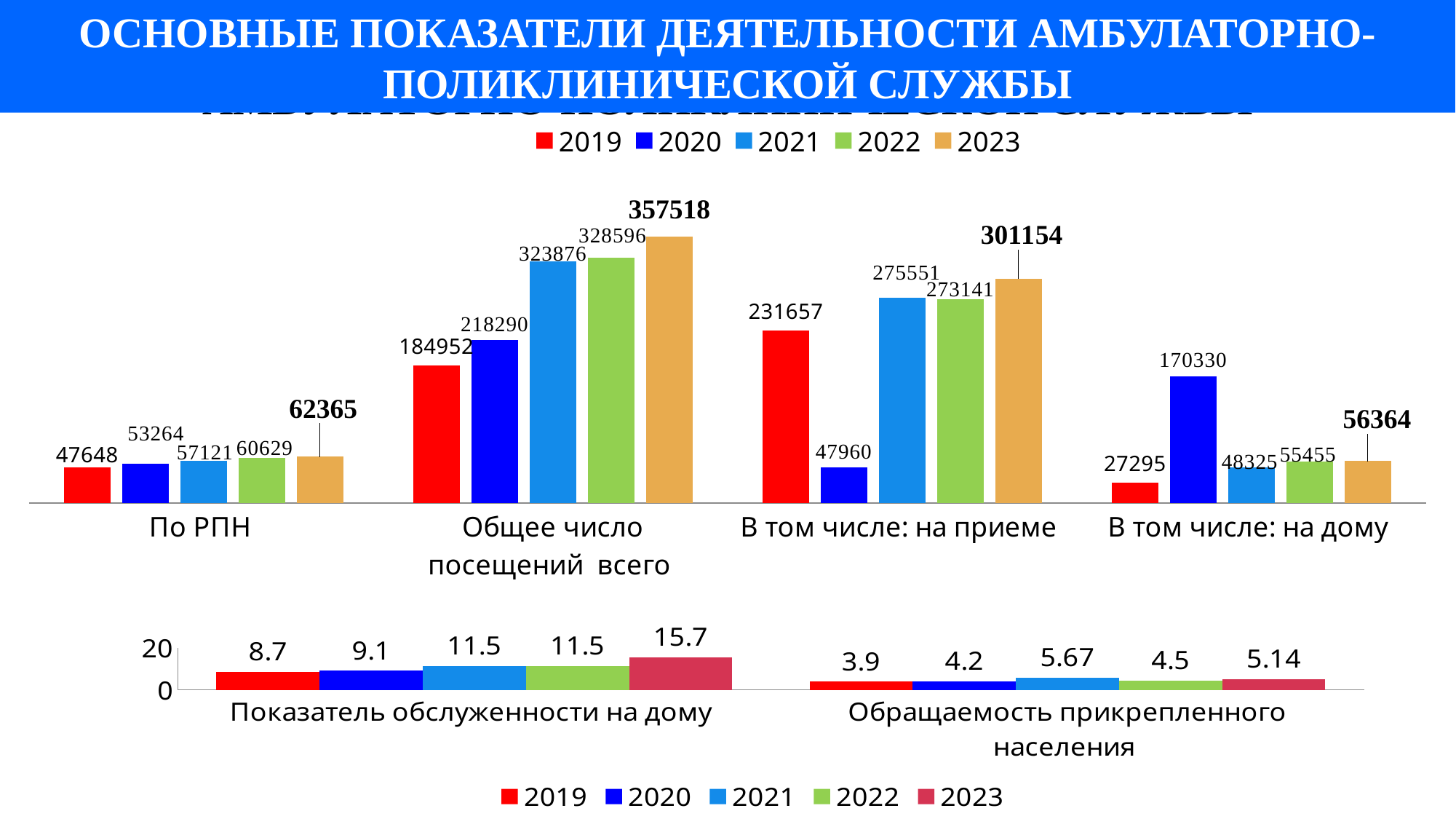
In the top chart, what is the difference between the 2023 and 2019 values in the category 'По РПН'? 14717 In the bottom chart, which year has the highest value in the category 'Обращаемость прикрепленного населения'? 2021 In the top chart, which year has the highest value in the category 'В том числе: на приеме'? 2023 In the top chart, what is the value for 2023 in the category 'Общее число посещений всего'? 357518 What kind of chart is the bottom chart? Bar chart In the top chart, which year has the lowest value in the category 'В том числе: на приеме'? 2020 In the top chart, how many series does the legend list? 5 In the bottom chart, what is the value for 2021 in the category 'Обращаемость прикрепленного населения'? 5.67 In the top chart, which is larger in the category 'Общее число посещений всего': the 2021 value or the 2022 value? 2022 In the top chart, what is the value for 2019 in the category 'По РПН'? 47648 In the top chart, what is the value for 2020 in the category 'В том числе: на дому'? 170330 In the bottom chart, what is the value for 2023 in the category 'Показатель обслуженности на дому'? 15.7